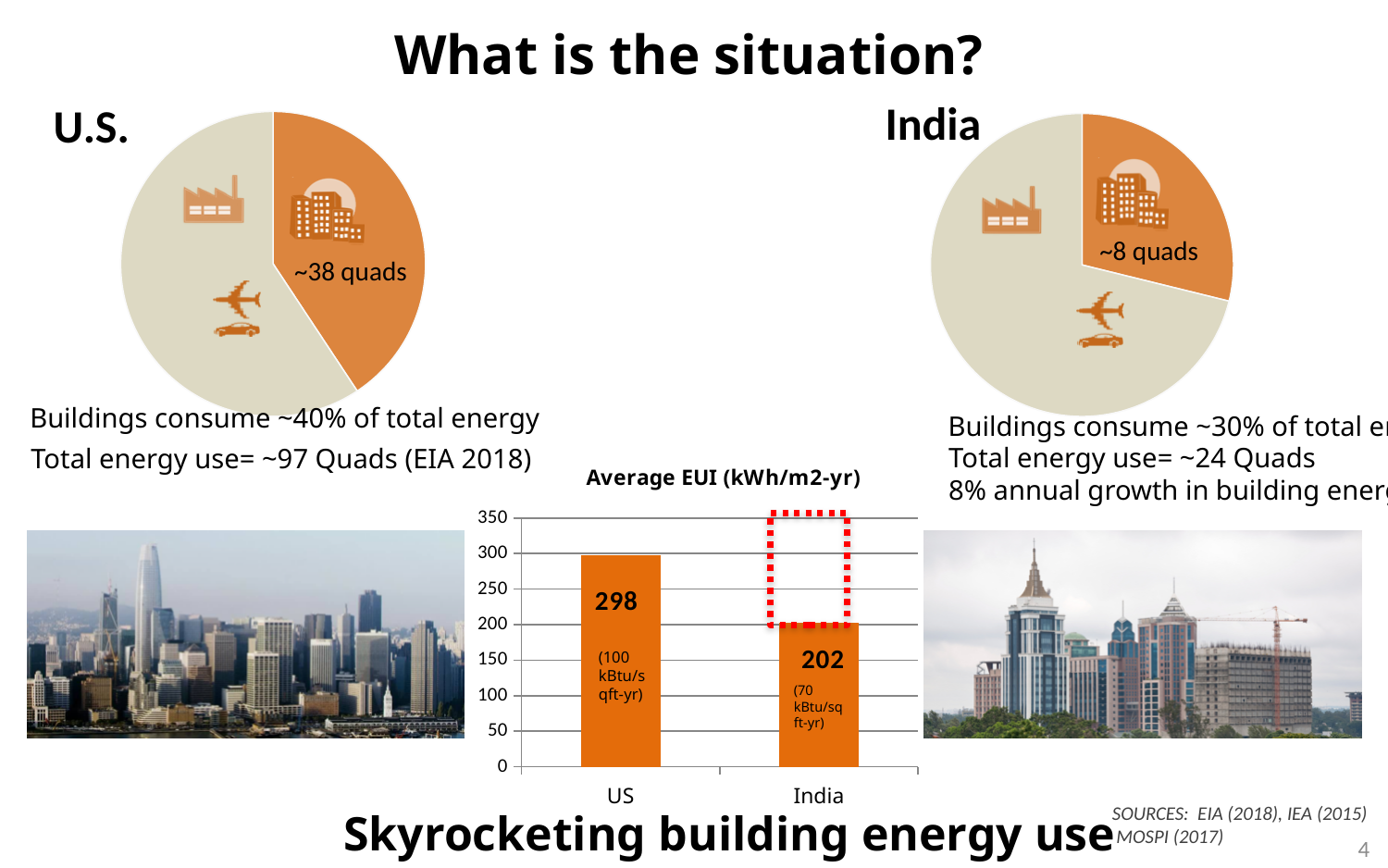
In the Average EUI (kWh/m2-yr) bar chart, is the value for US greater or less than 250? greater In the Average EUI (kWh/m2-yr) bar chart, which category has the highest value? US In the Average EUI (kWh/m2-yr) bar chart, how many categories are plotted? 2 In the Average EUI (kWh/m2-yr) bar chart, what is the value for India? 202 In the Average EUI (kWh/m2-yr) bar chart, what is the difference between the US and India values? 96 What label is printed on the orange slice of the India pie chart? ~8 quads Which pie chart, U.S. or India, shows the larger labelled orange slice in quads? U.S. What label is printed on the orange slice of the U.S. pie chart? ~38 quads In the Average EUI (kWh/m2-yr) bar chart, what is the value for US? 298 What is the title of the bar chart in the middle of the slide? Average EUI (kWh/m2-yr) What kind of chart is the Average EUI (kWh/m2-yr) chart? bar chart In the Average EUI (kWh/m2-yr) bar chart, which category has the lowest value? India